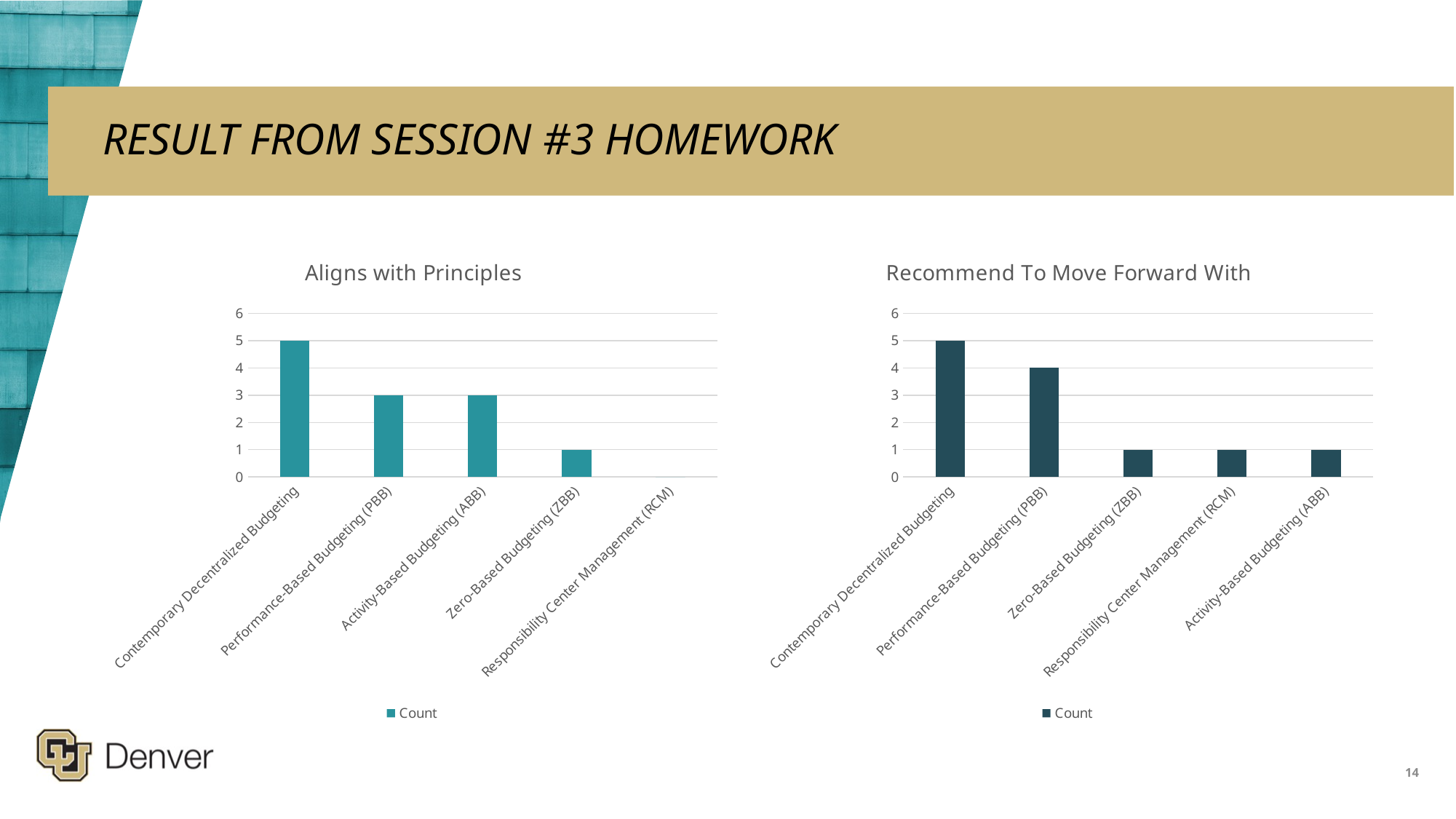
What kind of chart is the "Aligns with Principles" chart? Bar chart In the "Recommend To Move Forward With" chart, which category has the highest value? Contemporary Decentralized Budgeting In the "Recommend To Move Forward With" chart, what is the value for Performance-Based Budgeting (PBB)? 4 In the "Recommend To Move Forward With" chart, what is the value for Responsibility Center Management (RCM)? 1 In the "Aligns with Principles" chart, which category has the highest value? Contemporary Decentralized Budgeting In the "Aligns with Principles" chart, what is the value for Zero-Based Budgeting (ZBB)? 1 In the "Aligns with Principles" chart, what is the difference between Contemporary Decentralized Budgeting and Performance-Based Budgeting (PBB)? 2 In the "Recommend To Move Forward With" chart, which is larger: Performance-Based Budgeting (PBB) or Zero-Based Budgeting (ZBB)? Performance-Based Budgeting (PBB) In the "Aligns with Principles" chart, which category has the lowest value? Responsibility Center Management (RCM) How many series does the legend of the "Recommend To Move Forward With" chart list? 1 In the "Aligns with Principles" chart, what is the value for Contemporary Decentralized Budgeting? 5 How many categories are shown on the x axis of the "Recommend To Move Forward With" chart? 5